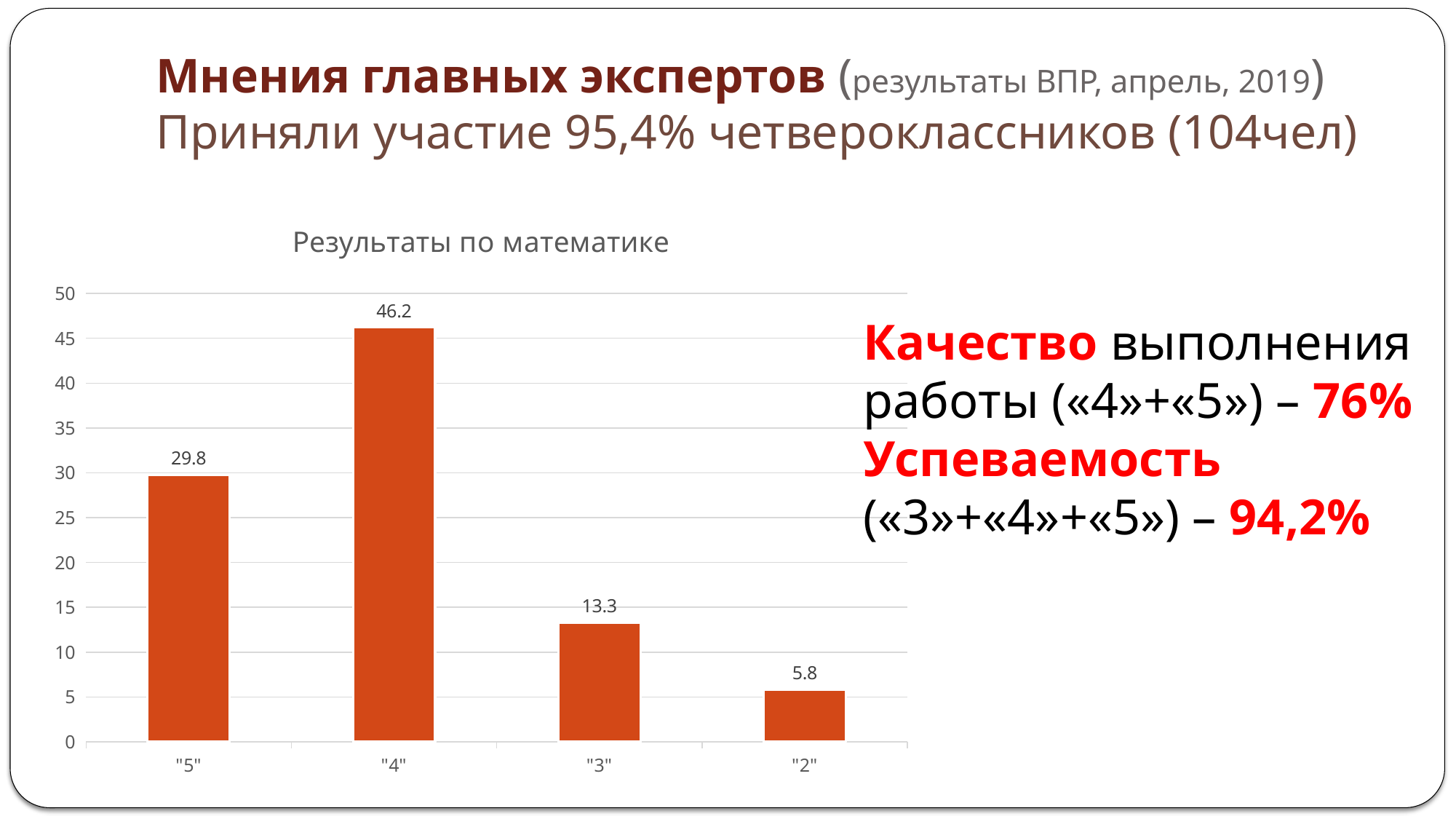
What is the value for "3" in the chart? 13.3 Which is larger, the value for "3" or the value for "2"? "3" How many categories are shown on the x axis? 4 What kind of chart is shown on the slide? bar chart What is the value for "2" in the chart? 5.8 Is the value for "5" greater or less than 25? greater What is the difference between the values for "4" and "5"? 16.4 What is the value for "5" in the chart? 29.8 What is the value for "4" in the chart? 46.2 What is the title of the chart? Результаты по математике Which category has the lowest value? "2" Which category has the highest value? "4"